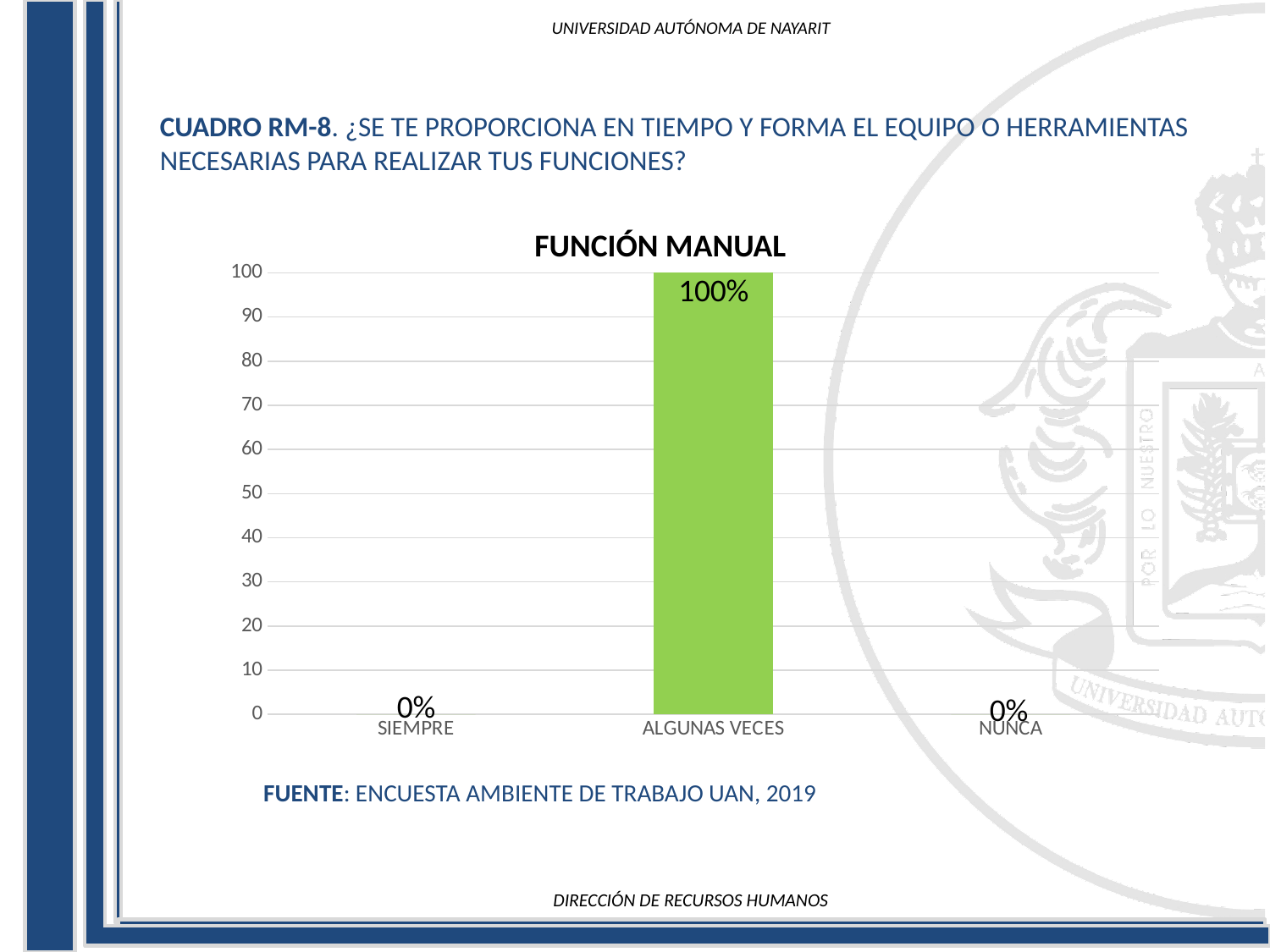
What is the value for SIEMPRE? 0% What is the title of the chart? FUNCIÓN MANUAL What is the value for NUNCA? 0% What is the value for ALGUNAS VECES? 100% What kind of chart is shown? bar chart Which is larger, the value for ALGUNAS VECES or the value for NUNCA? ALGUNAS VECES What is the difference between the values for ALGUNAS VECES and SIEMPRE? 100% Is the value for ALGUNAS VECES greater or less than 50? greater What is the highest value shown on the vertical axis? 100 Which category has the highest value? ALGUNAS VECES How many categories are shown on the x axis? 3